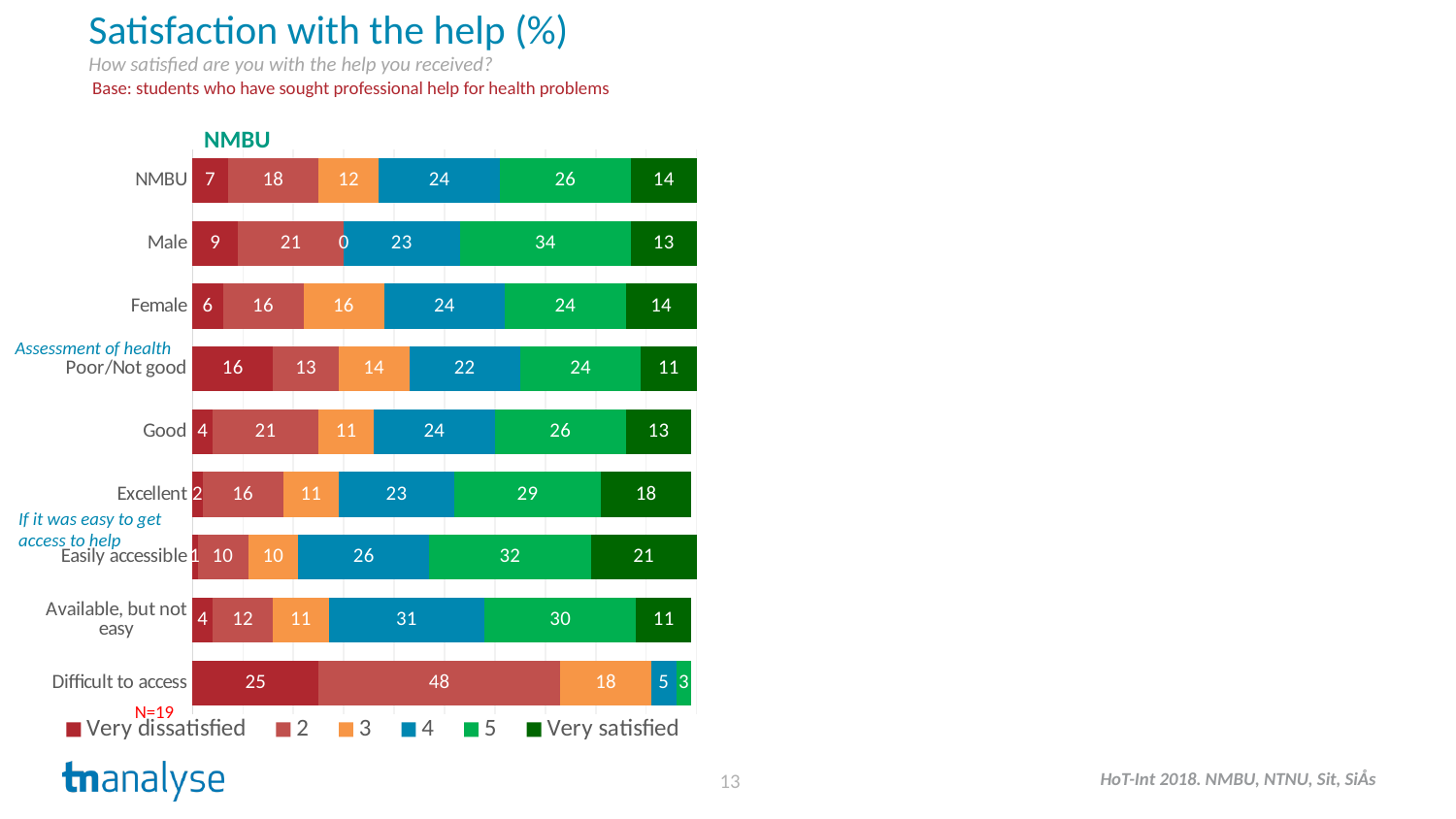
Which category has the highest 'Very dissatisfied' value? Difficult to access How many series does the legend list? 6 What kind of chart is shown on the slide? Stacked bar chart What is the value of series '2' for 'Difficult to access'? 48 What is the 'Very satisfied' value for 'Easily accessible'? 21 Which has the larger 'Very satisfied' value, 'Excellent' or 'Good'? Excellent How many categories (bars) are plotted in the chart? 9 What is the value of series '4' for 'Available, but not easy'? 31 What is the difference between the series '5' values for 'Male' and 'Female'? 10 Which category has the highest 'Very satisfied' value? Easily accessible What is the 'Very dissatisfied' value for 'Difficult to access'? 25 What is the value of series '3' for 'Male'? 0